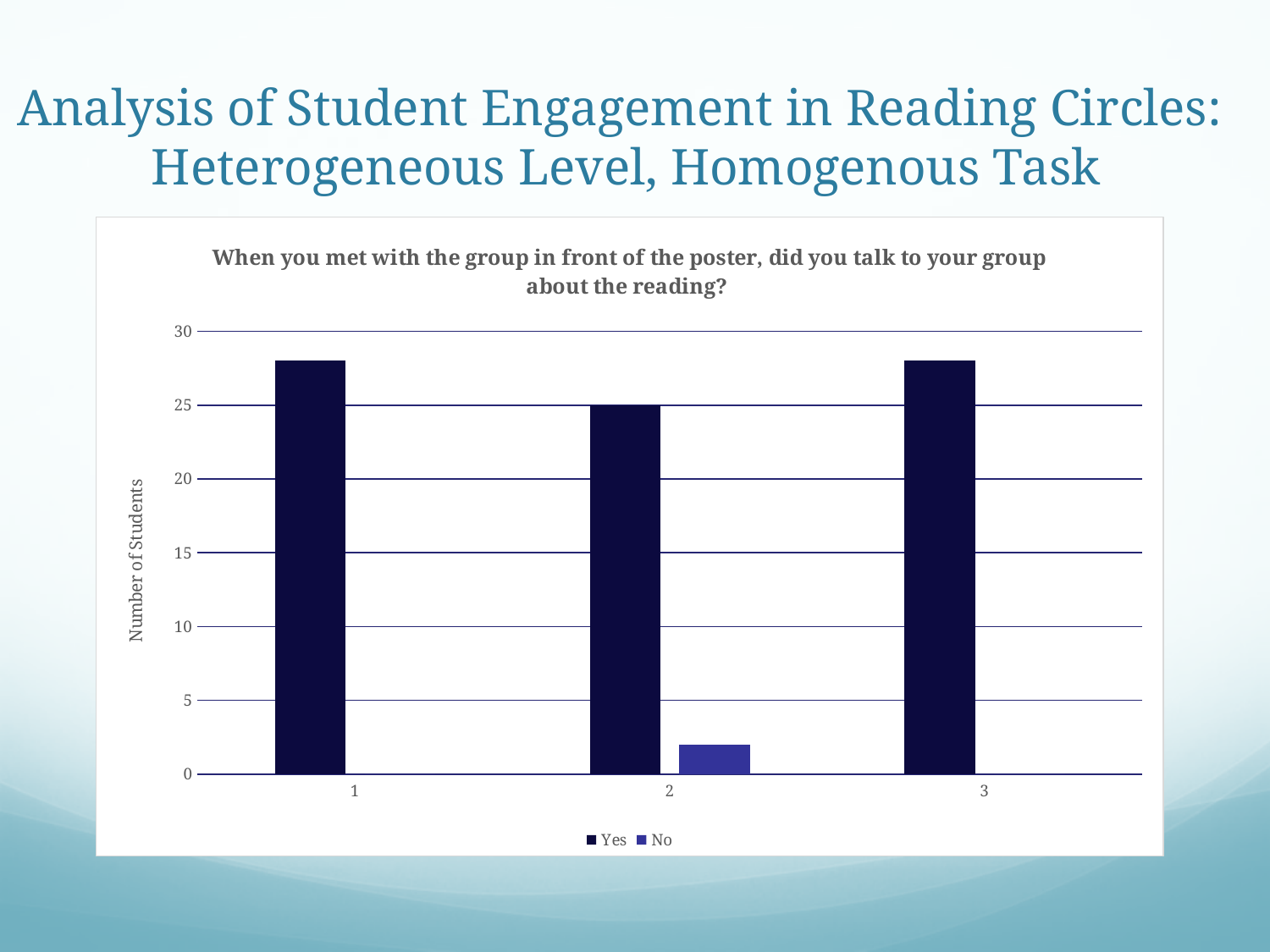
Is the value of the Yes series for category 1 greater or less than 25? greater How many series does the legend list? 2 Which is larger, the Yes value for category 1 or the Yes value for category 2? category 1 What is the value of the Yes series for category 2? 25 Is the value of the No series for category 2 greater or less than 5? less Is the value of the Yes series for category 2 greater or less than 30? less Which category has the lowest value for the Yes series? 2 How many categories are shown on the x axis? 3 What kind of chart is shown on the slide? bar chart For category 2, which series has the larger value, Yes or No? Yes What is the title of the y axis? Number of Students